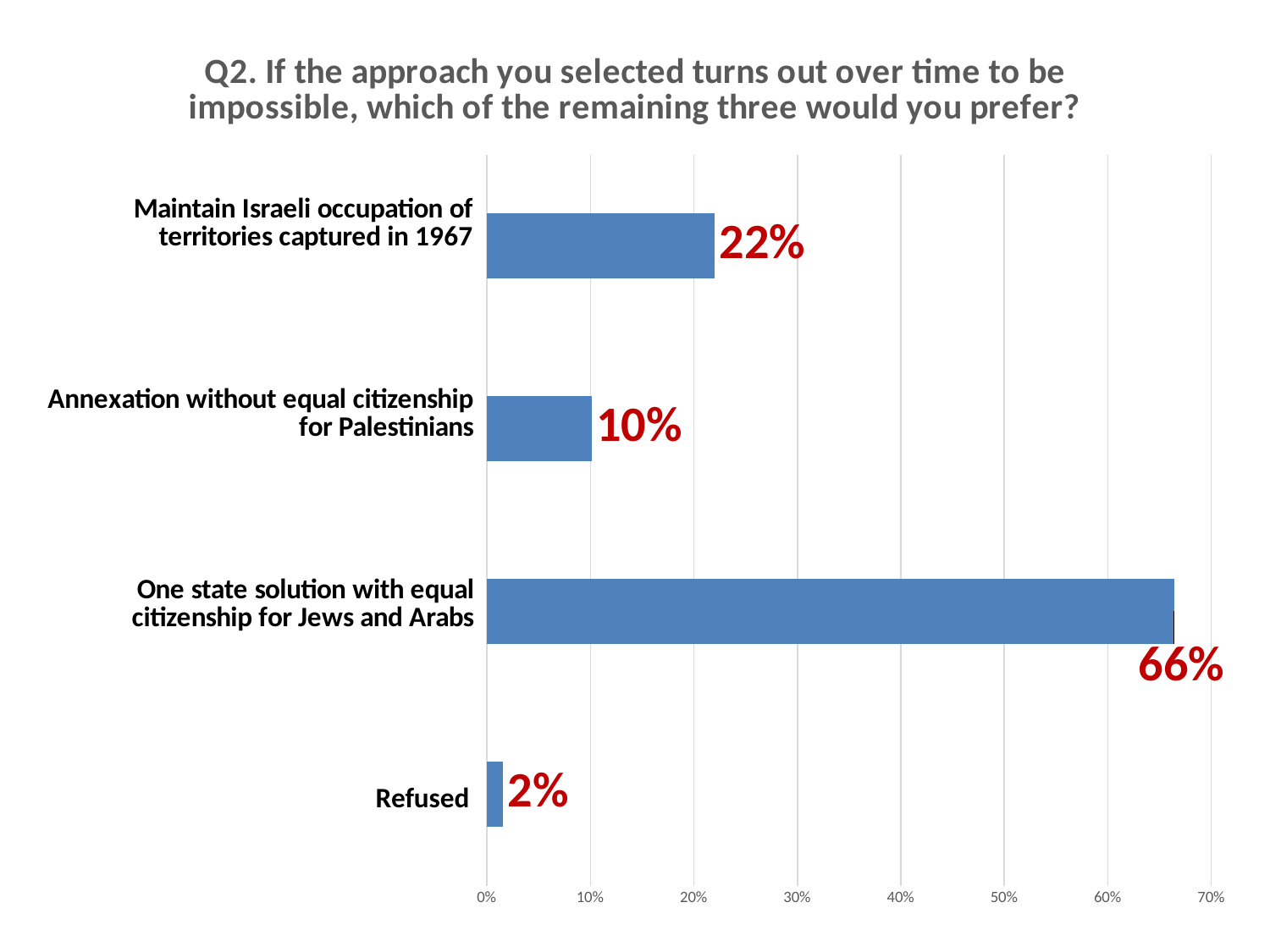
What is the difference between the values for 'One state solution with equal citizenship for Jews and Arabs' and 'Maintain Israeli occupation of territories captured in 1967'? 44% Which category has the lowest value? Refused What percentage of respondents refused to answer? 2% Which category has the highest value? One state solution with equal citizenship for Jews and Arabs What is the value for 'Maintain Israeli occupation of territories captured in 1967'? 22% What kind of chart is shown on the slide? Bar chart What is the highest value shown on the x axis? 70% What is the difference between the values for 'Maintain Israeli occupation of territories captured in 1967' and 'Annexation without equal citizenship for Palestinians'? 12% What percentage of respondents chose 'One state solution with equal citizenship for Jews and Arabs'? 66% Which is larger: the value for 'Maintain Israeli occupation of territories captured in 1967' or for 'Annexation without equal citizenship for Palestinians'? Maintain Israeli occupation of territories captured in 1967 What is the value for 'Annexation without equal citizenship for Palestinians'? 10% How many categories are shown in the chart? 4